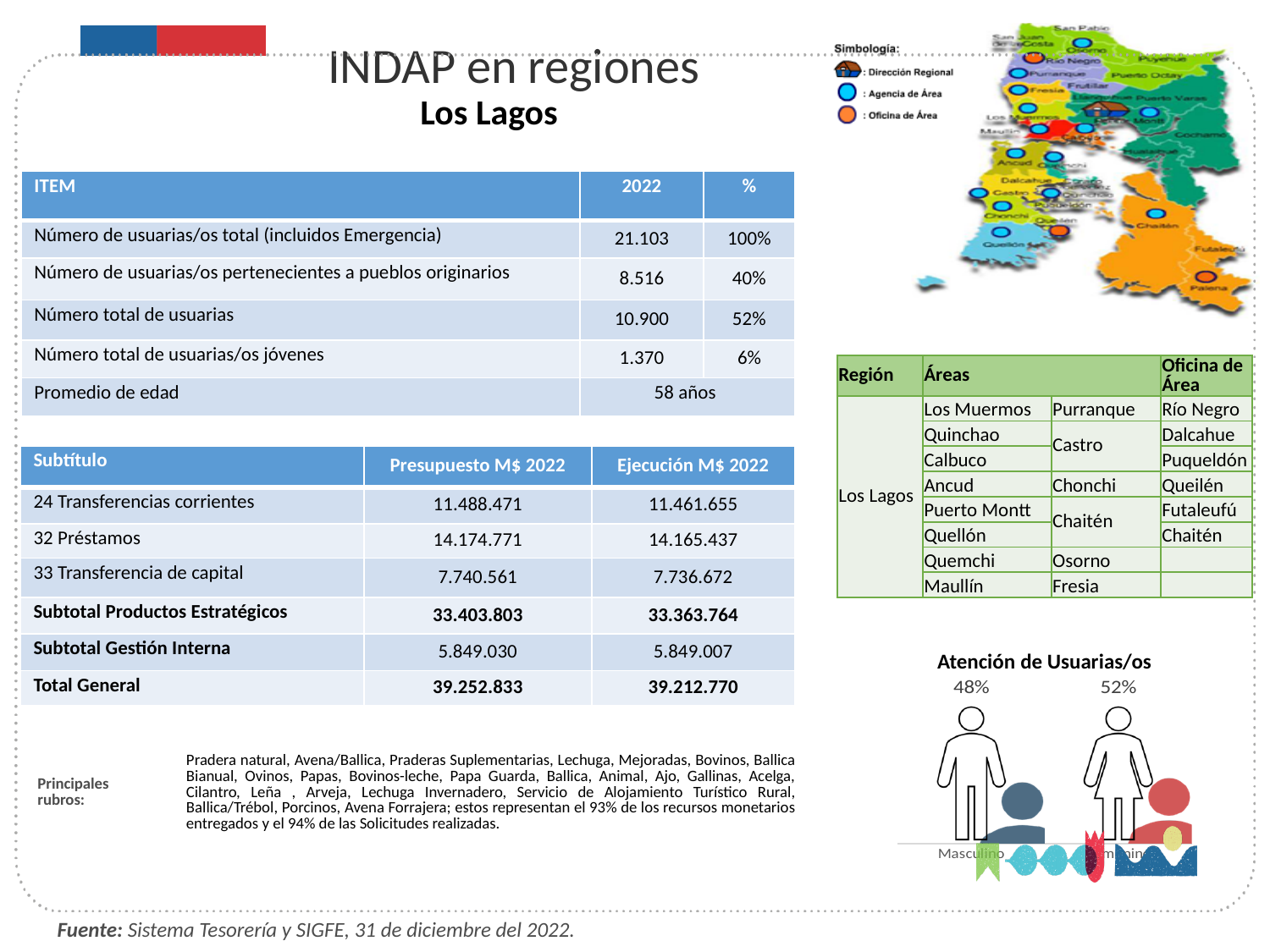
In the 'Atención de Usuarias/os' chart, is the value for Masculino greater or less than 50%? less In the 'Atención de Usuarias/os' chart, do the two percentages add up to 100%? Yes In the 'Atención de Usuarias/os' chart, which category has the lowest percentage? Masculino In the 'Atención de Usuarias/os' chart, what percentage is shown for the right-hand (female) category? 52% In the 'Atención de Usuarias/os' chart, what percentage is shown for Masculino? 48% How many categories are shown in the 'Atención de Usuarias/os' chart? 2 In the 'Atención de Usuarias/os' chart, which category is shown on the left? Masculino What is the title of the chart in the lower right of the slide? Atención de Usuarias/os In the 'Atención de Usuarias/os' chart, which category has the higher percentage, Masculino or the female category? Female (52%) In the 'Atención de Usuarias/os' chart, what is the difference in percentage points between the two categories? 4 percentage points